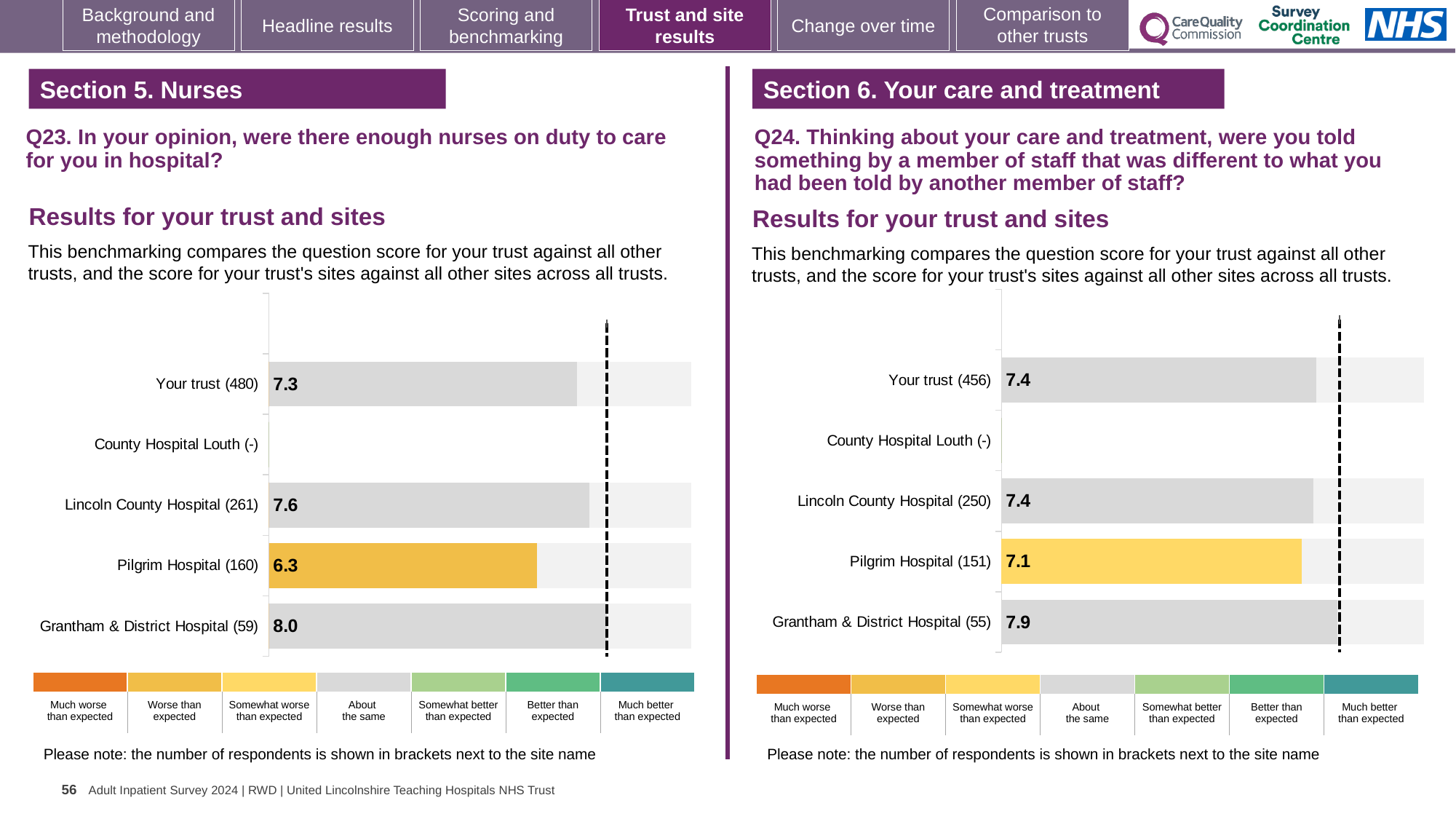
On the Q23 chart (left), which site has the lowest score? Pilgrim Hospital On the Q24 chart (right), what is the score for Lincoln County Hospital? 7.4 On the Q24 chart (right), what is the score for Grantham & District Hospital? 7.9 What kind of chart is used on the Q23 chart (left)? Bar chart On the Q24 chart (right), what is the difference between the scores for Your trust and Pilgrim Hospital? 0.3 On the Q23 chart (left), what is the difference between the scores for Grantham & District Hospital and Pilgrim Hospital? 1.7 On the Q23 chart (left), what is the score for Pilgrim Hospital? 6.3 On the Q23 chart (left), how many respondents are shown for Lincoln County Hospital? 261 On the Q24 chart (right), which site has the lowest score? Pilgrim Hospital On the Q23 chart (left), what is the score for Your trust? 7.3 On the Q24 chart (right), which is larger: the score for Grantham & District Hospital or the score for Your trust? Grantham & District Hospital On the Q23 chart (left), which site has the highest score? Grantham & District Hospital